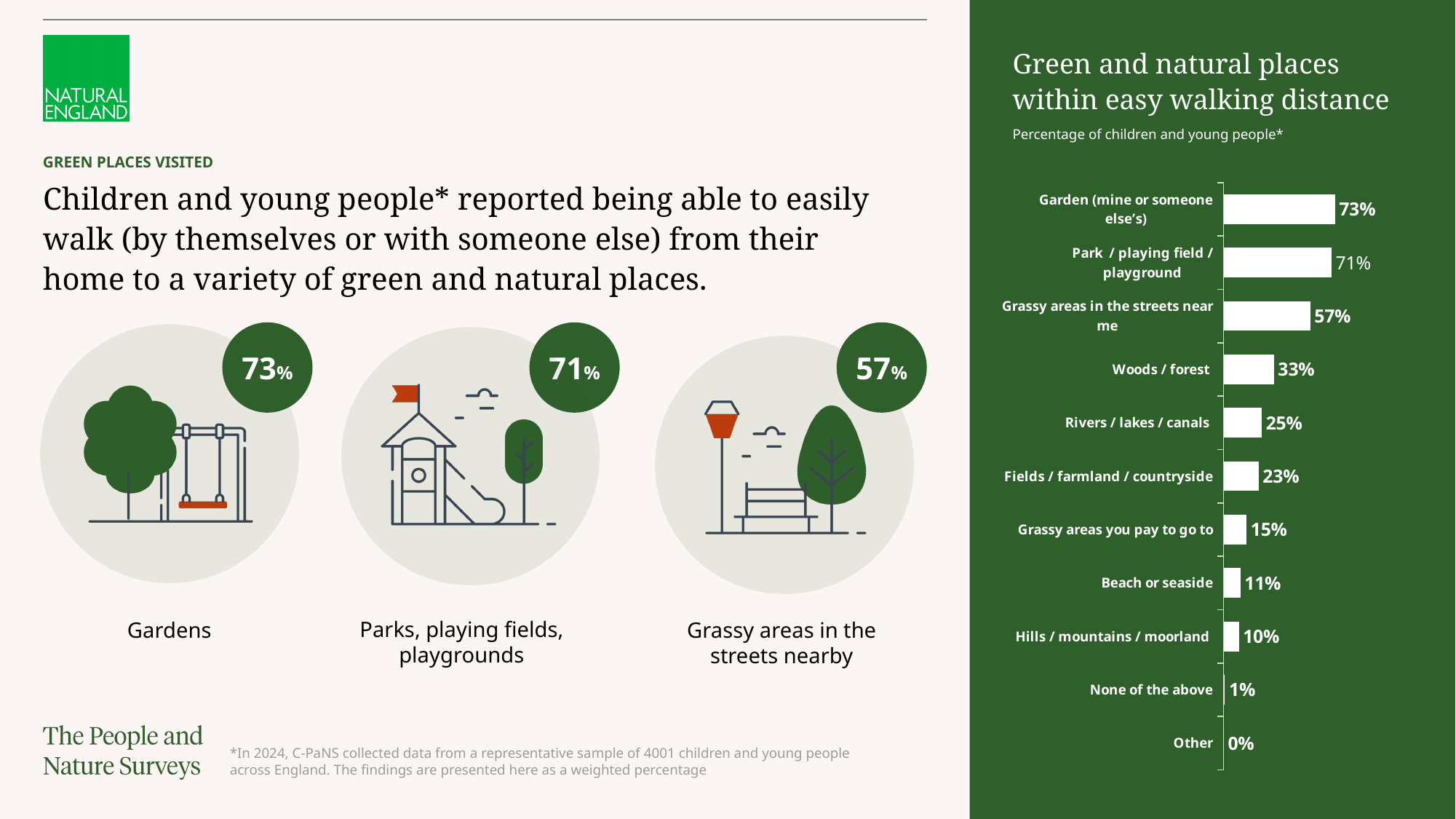
What kind of chart is 'Green and natural places within easy walking distance'? Bar chart In the 'Green and natural places within easy walking distance' chart, what is the difference between the percentages for Grassy areas in the streets near me and Woods / forest? 24% How many categories are shown in the 'Green and natural places within easy walking distance' chart? 11 In the 'Green and natural places within easy walking distance' chart, what percentage is shown for Woods / forest? 33% In the 'Green and natural places within easy walking distance' chart, what percentage is shown for Rivers / lakes / canals? 25% In the 'Green and natural places within easy walking distance' chart, which category has the lowest percentage? Other In the 'Green and natural places within easy walking distance' chart, which is larger: Fields / farmland / countryside or Grassy areas you pay to go to? Fields / farmland / countryside In the 'Green and natural places within easy walking distance' chart, which is larger: Hills / mountains / moorland or Rivers / lakes / canals? Rivers / lakes / canals In the 'Green and natural places within easy walking distance' chart, what is the difference between the percentages for Garden (mine or someone else's) and Park / playing field / playground? 2% In the 'Green and natural places within easy walking distance' chart, what percentage is shown for Beach or seaside? 11% What is the subtitle shown under the title of the 'Green and natural places within easy walking distance' chart? Percentage of children and young people* In the 'Green and natural places within easy walking distance' chart, which category has the highest percentage? Garden (mine or someone else's)